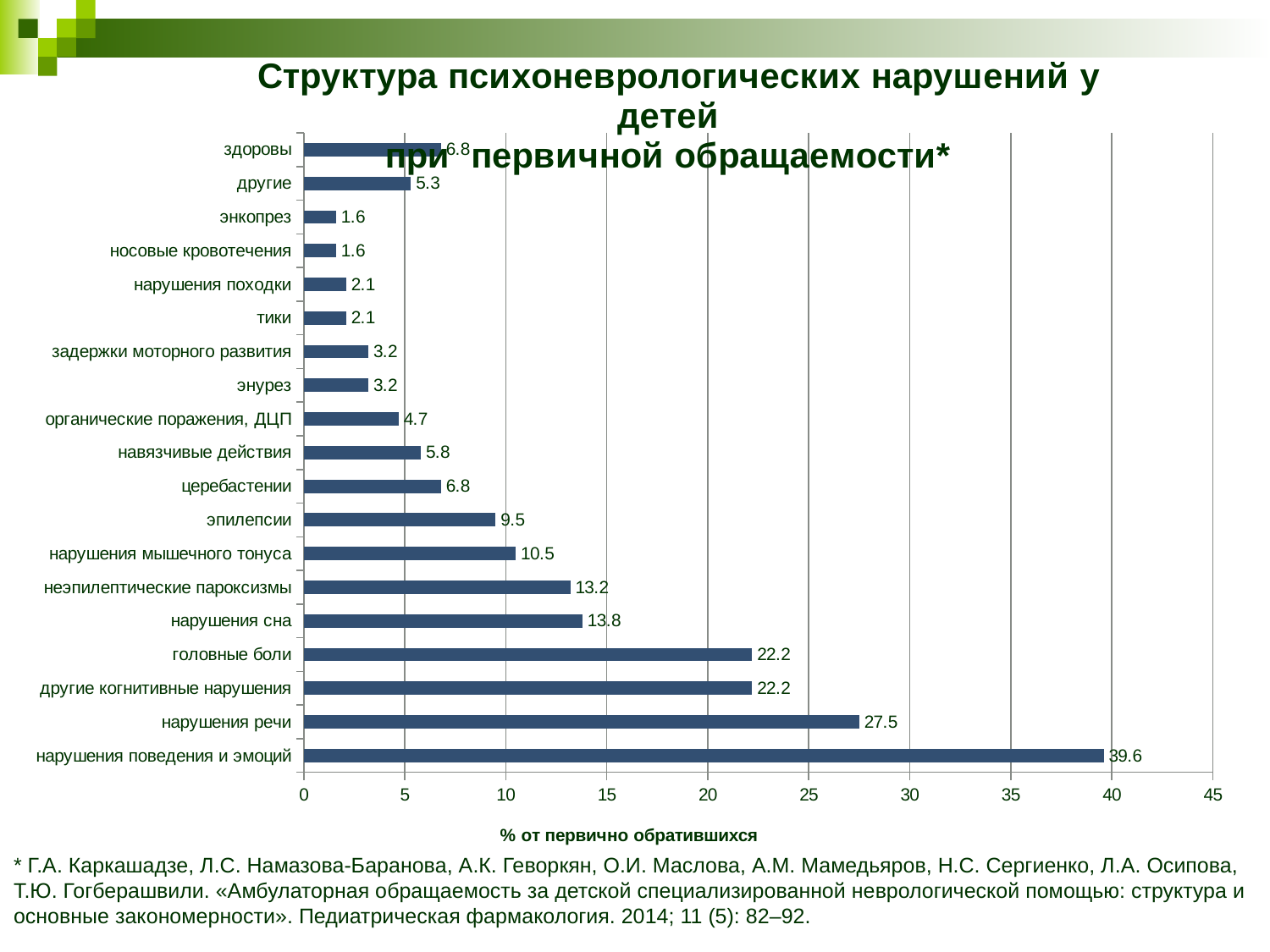
How many categories are shown in the chart? 19 What value is shown for нарушения поведения и эмоций? 39.6 What is the difference between the values for нарушения сна and неэпилептические пароксизмы? 0.6 What value is shown for эпилепсии? 9.5 Is the value for нарушения поведения и эмоций greater or less than 35? greater What value is shown for нарушения сна? 13.8 What is the difference between the values for нарушения речи and головные боли? 5.3 What value is shown for нарушения речи? 27.5 Which is larger, the value for нарушения мышечного тонуса or the value for церебастении? нарушения мышечного тонуса Which category has the highest value? нарушения поведения и эмоций What kind of chart is shown on the slide? bar chart What is the title of the horizontal axis? % от первично обратившихся